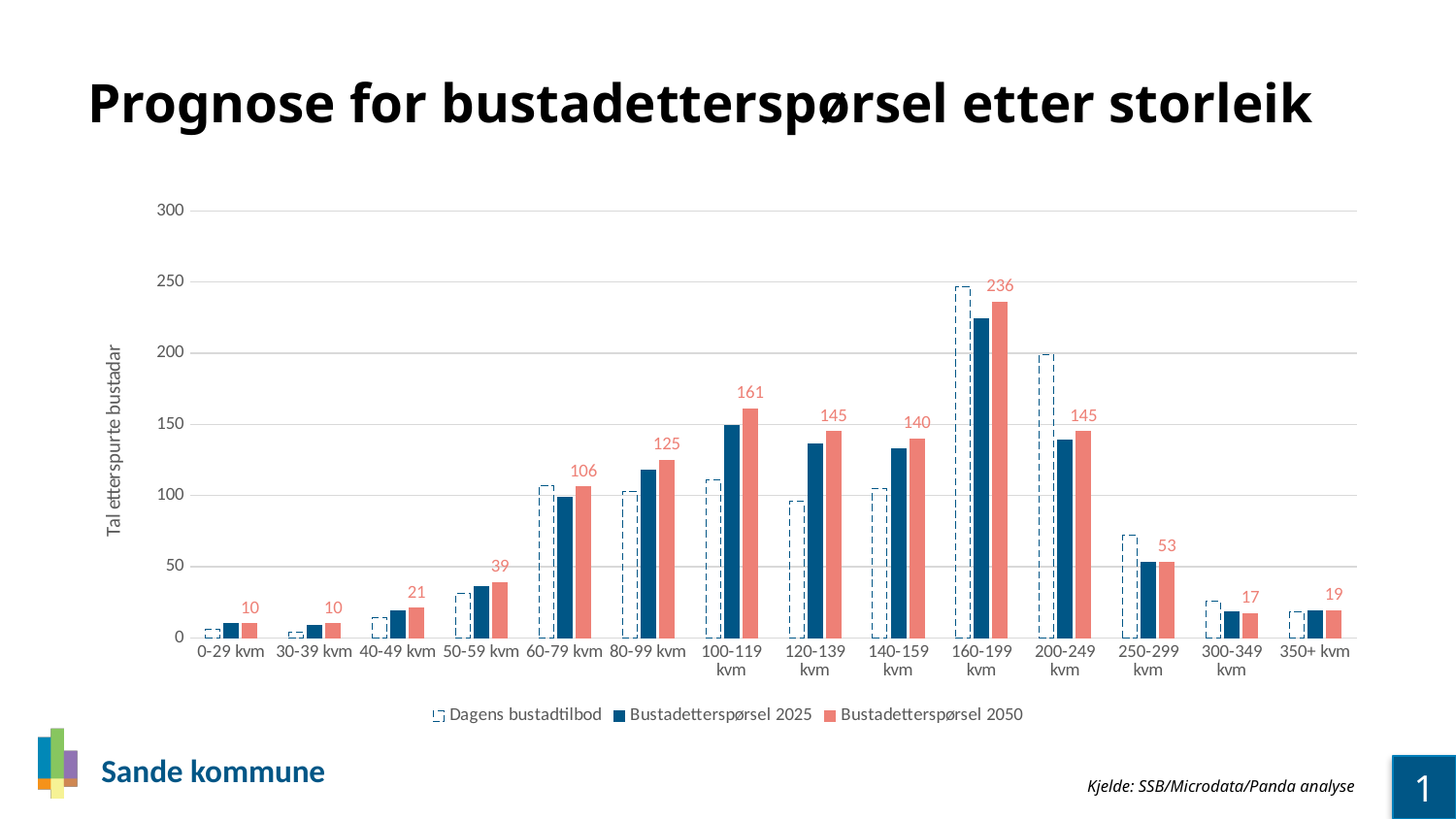
How many series does the legend list? 3 What is the difference between the Bustadetterspørsel 2050 values for 160-199 kvm and 100-119 kvm? 75 Is the value for Dagens bustadtilbod in the 250-299 kvm category greater or less than 50? greater Which category has the highest value for Bustadetterspørsel 2050? 160-199 kvm How many size categories are shown on the x axis? 14 Which is larger for Bustadetterspørsel 2050: 80-99 kvm or 140-159 kvm? 140-159 kvm What is the value for Bustadetterspørsel 2050 in the 100-119 kvm category? 161 What is the value for Bustadetterspørsel 2050 in the 50-59 kvm category? 39 What is the label of the vertical axis? Tal etterspurte bustadar What kind of chart is shown on the slide? Bar chart What is the value for Bustadetterspørsel 2050 in the 160-199 kvm category? 236 Is the value for Dagens bustadtilbod in the 160-199 kvm category greater or less than 200? greater